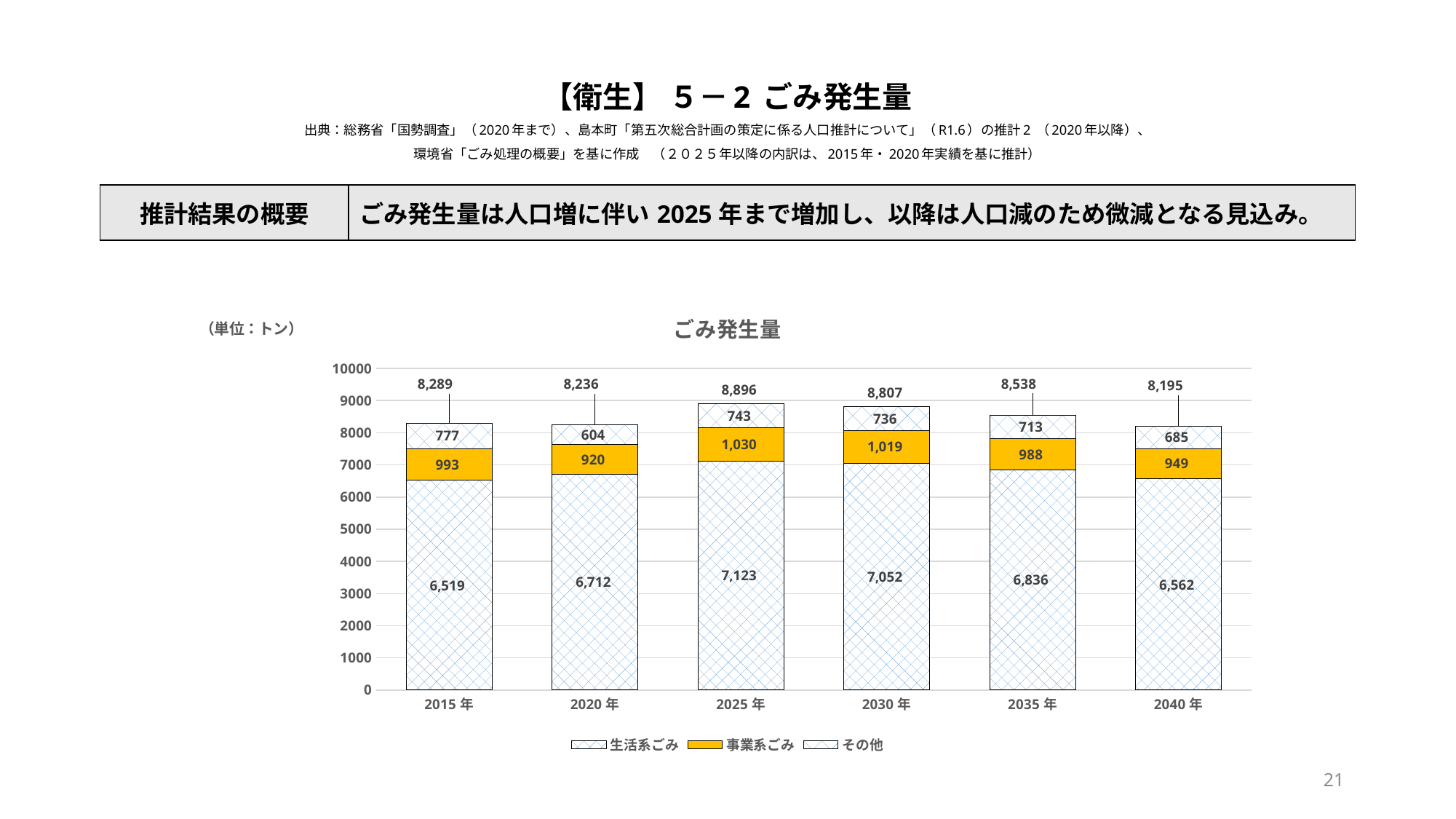
Which year has the lowest total ごみ発生量? 2040年 What is the difference between the 生活系ごみ values for 2025年 and 2040年? 561 What is the value of 生活系ごみ for 2025年? 7,123 What kind of chart is shown? Stacked bar chart How many years are shown on the x axis? 6 What is the value of その他 for 2020年? 604 Which year has the highest total ごみ発生量? 2025年 Which is larger, the 事業系ごみ value for 2015年 or for 2035年? 2015年 What is the total ごみ発生量 shown above the bar for 2030年? 8,807 What is the value of 事業系ごみ for 2040年? 949 What is the unit of the values shown in the chart? トン How many series does the legend list? 3